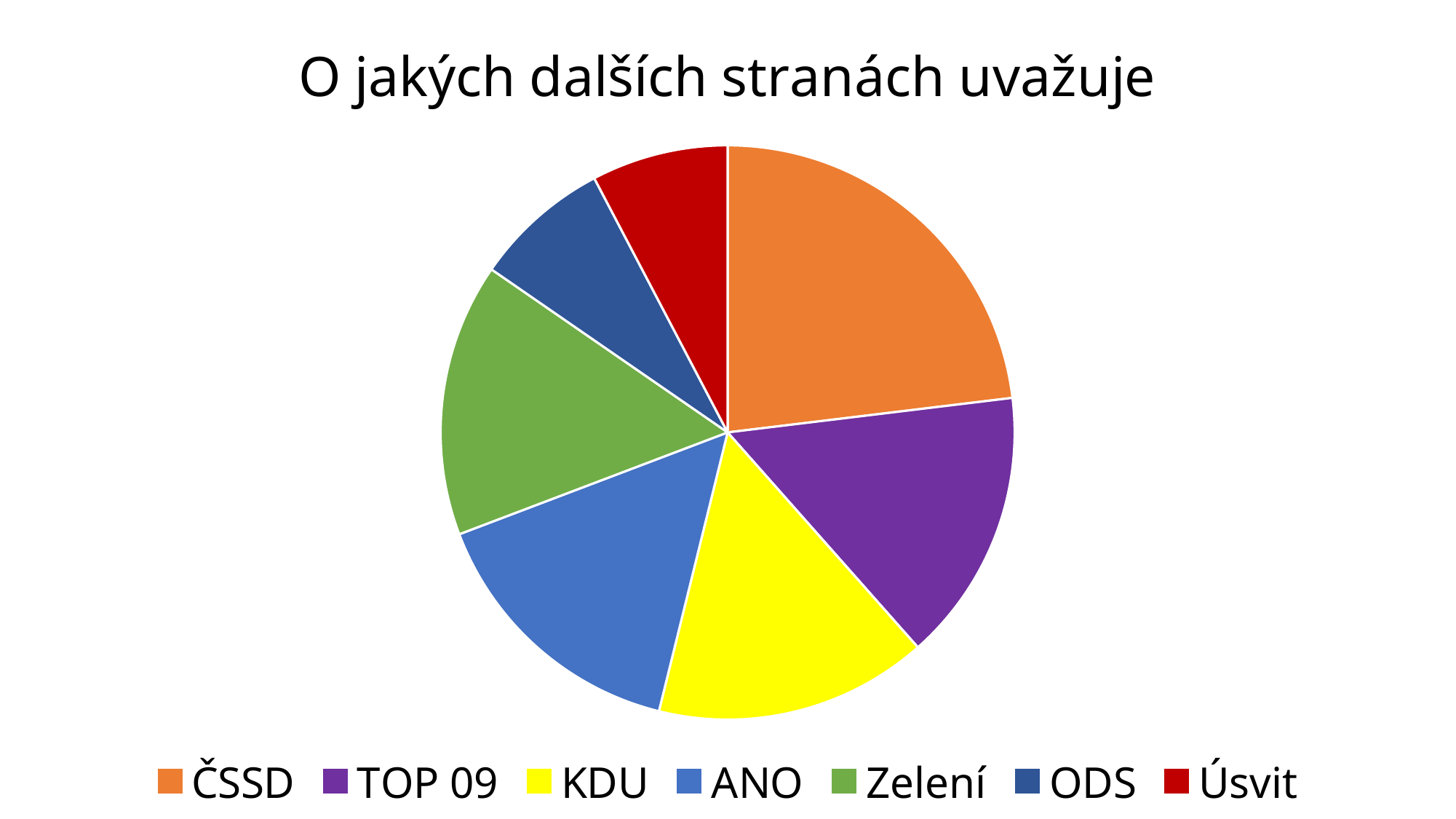
What colour is the slice for KDU? yellow How many slices does the pie chart have? 7 Which slice is larger, ANO or Úsvit? ANO Which slice is larger, Zelení or ODS? Zelení What kind of chart is shown on the slide? pie chart Which slice is larger, KDU or Úsvit? KDU How many entries does the legend list? 7 Which party has the largest slice of the pie? ČSSD What is the title of the chart? O jakých dalších stranách uvažuje